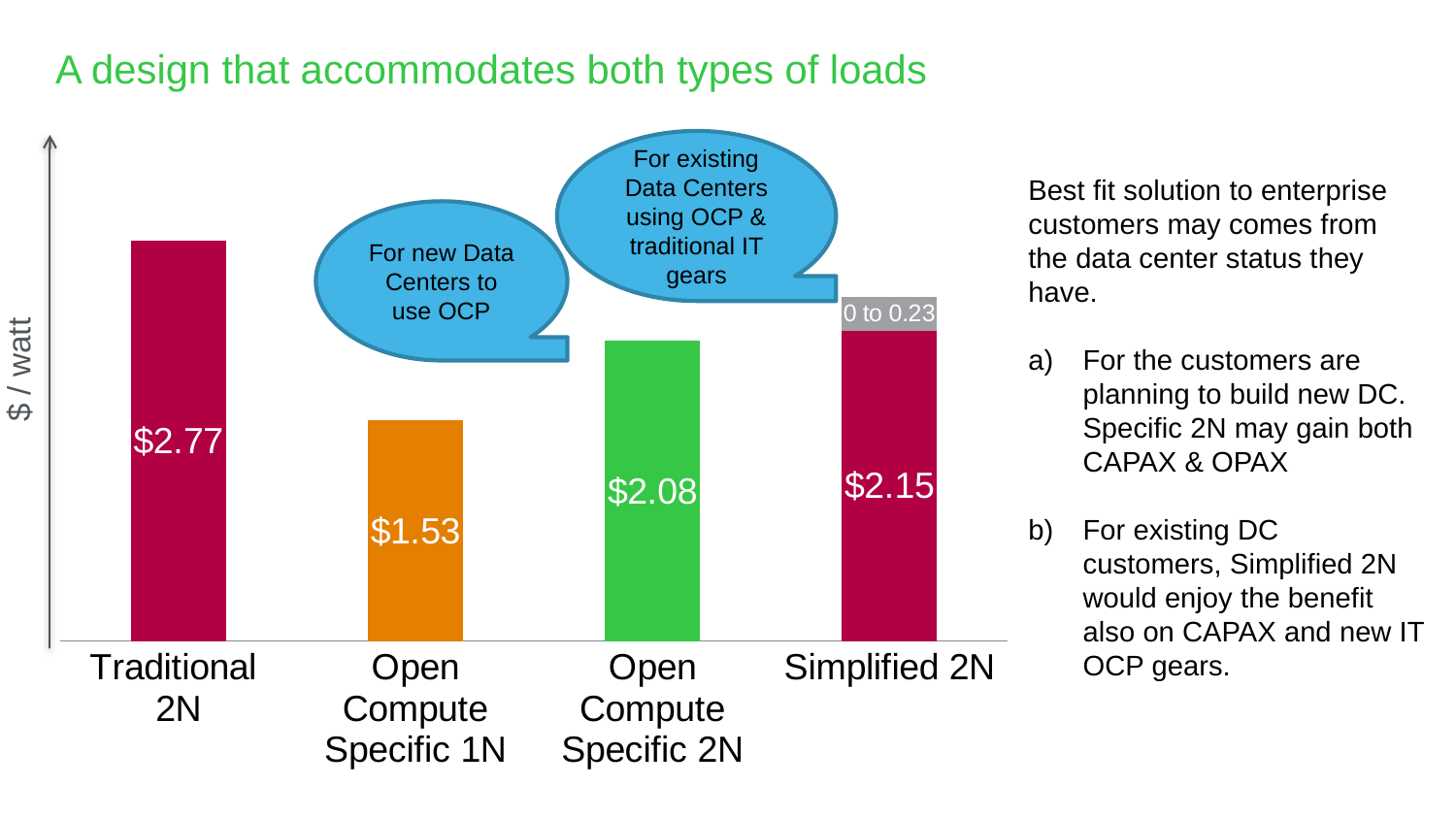
How many categories are shown on the x axis? 4 What is the value for Open Compute Specific 1N? $1.53 What is the value for Traditional 2N? $2.77 What is the difference between Traditional 2N and Open Compute Specific 1N? $1.24 What label is shown on the grey segment on top of the Simplified 2N bar? 0 to 0.23 What is the value for Open Compute Specific 2N? $2.08 What is the value labelled on the main (red) portion of the Simplified 2N bar? $2.15 Which category has the highest value? Traditional 2N Which is larger, Open Compute Specific 2N or Open Compute Specific 1N? Open Compute Specific 2N What is the label of the vertical axis? $ / watt What is the difference between Traditional 2N and Open Compute Specific 2N? $0.69 Which category has the lowest value? Open Compute Specific 1N